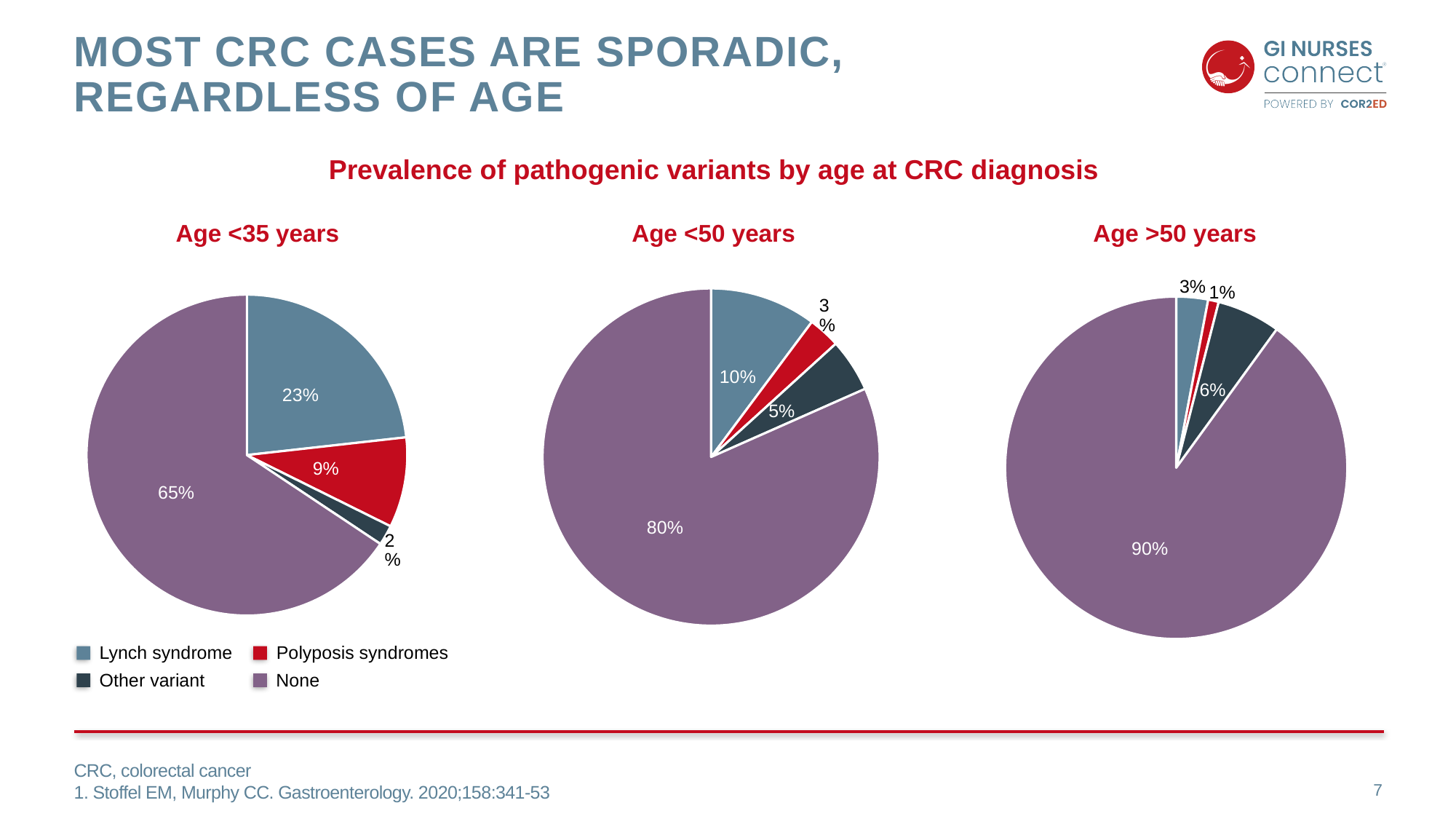
In the Age >50 years pie chart, what share is labelled for Polyposis syndromes? 1% In the Age <35 years pie chart, what share is labelled for None? 65% In the Age <35 years pie chart, what is the difference between the Lynch syndrome share and the Polyposis syndromes share? 14% How many categories does the legend list for the pie charts? 4 In the Age >50 years pie chart, which category has the largest slice? None In the Age <50 years pie chart, which is larger: the Lynch syndrome slice or the Polyposis syndromes slice? Lynch syndrome In the Age <35 years pie chart, what share is labelled for Lynch syndrome? 23% In the Age <50 years pie chart, what share is labelled for Other variant? 5% What is the title shown above the three pie charts? Prevalence of pathogenic variants by age at CRC diagnosis What type of chart is used to show the prevalence of pathogenic variants by age? Pie chart In the Age <35 years pie chart, which category has the smallest slice? Other variant What is the difference between the None share in the Age >50 years chart and the None share in the Age <35 years chart? 25%